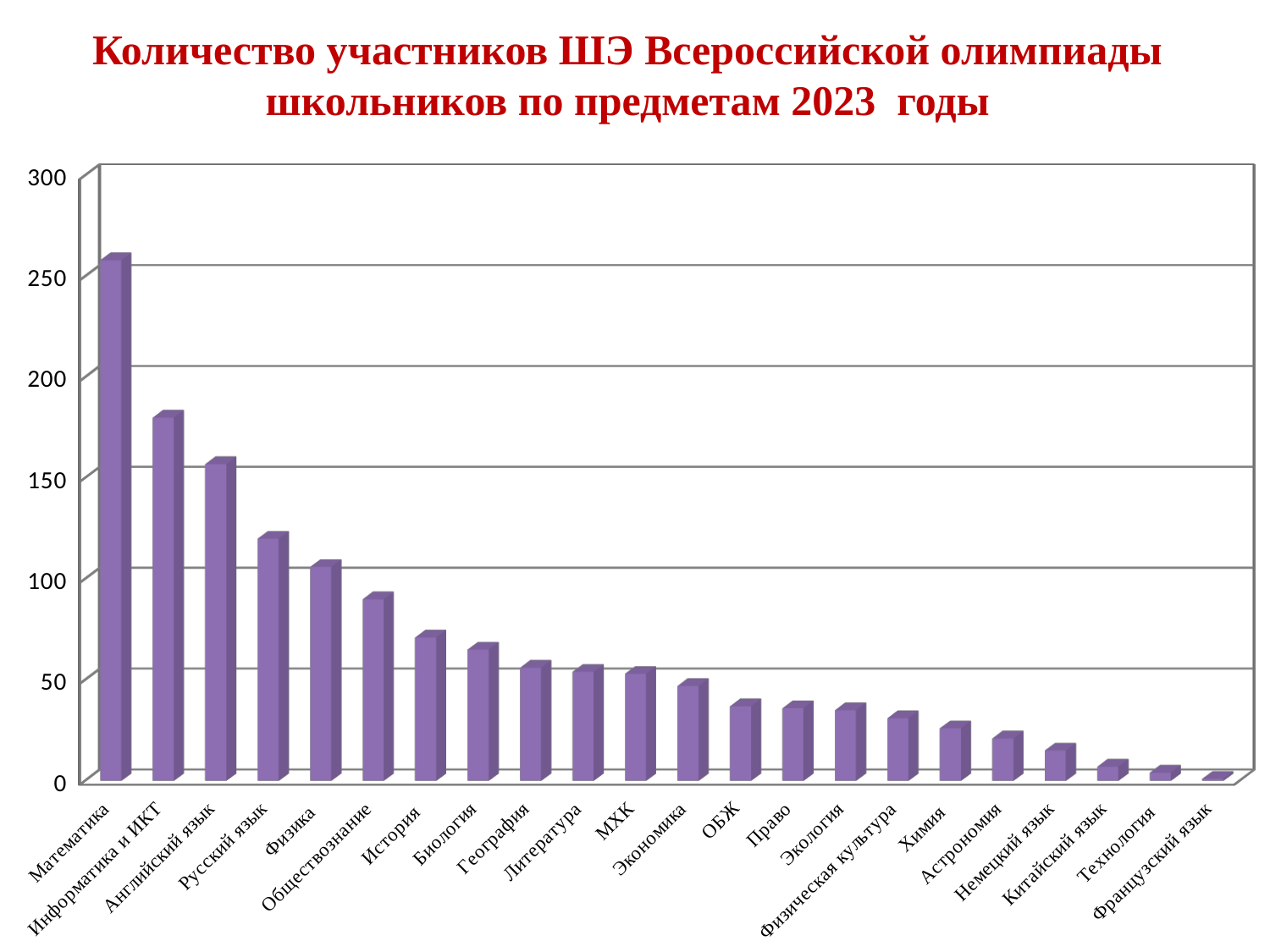
Do the values rise or fall moving from left to right along the x axis? fall Is the value for Обществознание greater or less than 100? less Is the value for Математика greater or less than 250? greater Which subject has the highest number of participants? Математика What kind of chart is shown on the slide? bar chart Which subject has the lowest number of participants? Французский язык Is the value for Информатика и ИКТ greater or less than 200? less What is the title of the chart? Количество участников ШЭ Всероссийской олимпиады школьников по предметам 2023 годы How many subjects (categories) are shown on the x axis? 22 Which has more participants, Английский язык or Русский язык? Английский язык